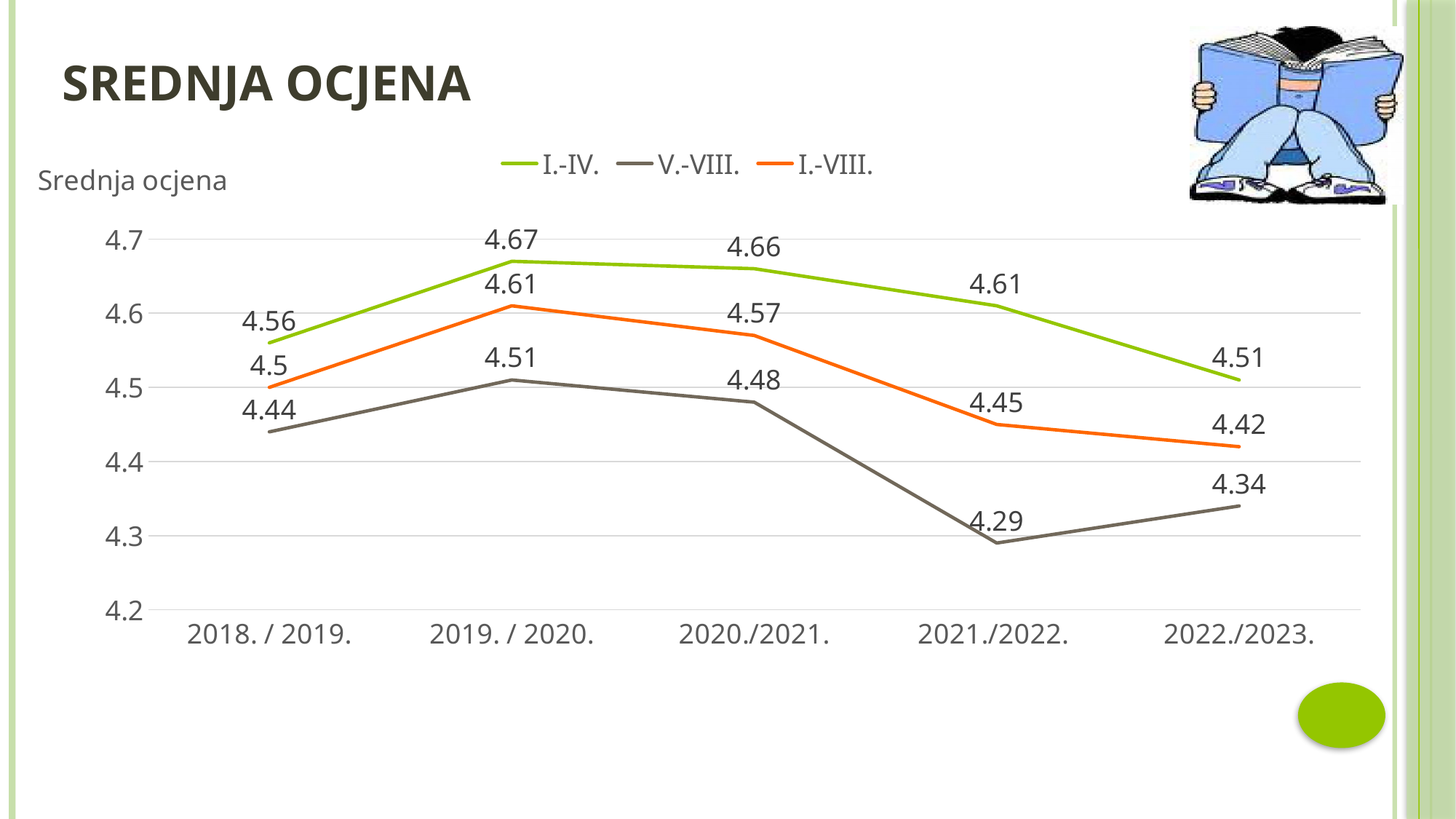
What is the value for I.-VIII. in 2022./2023.? 4.42 In which school year is the V.-VIII. series lowest? 2021./2022. What is the value for V.-VIII. in 2021./2022.? 4.29 How many school years are shown on the x axis? 5 How many series does the legend list? 3 What is the difference between the I.-IV. and V.-VIII. values in 2021./2022.? 0.32 Does the I.-VIII. series rise or fall from 2019. / 2020. to 2022./2023.? fall What is the title of the chart? Srednja ocjena What type of chart is shown on the slide? line chart What is the value for I.-IV. in 2019. / 2020.? 4.67 In which school year is the I.-IV. series highest? 2019. / 2020. Which is larger in 2018. / 2019.: the I.-IV. value or the V.-VIII. value? I.-IV.